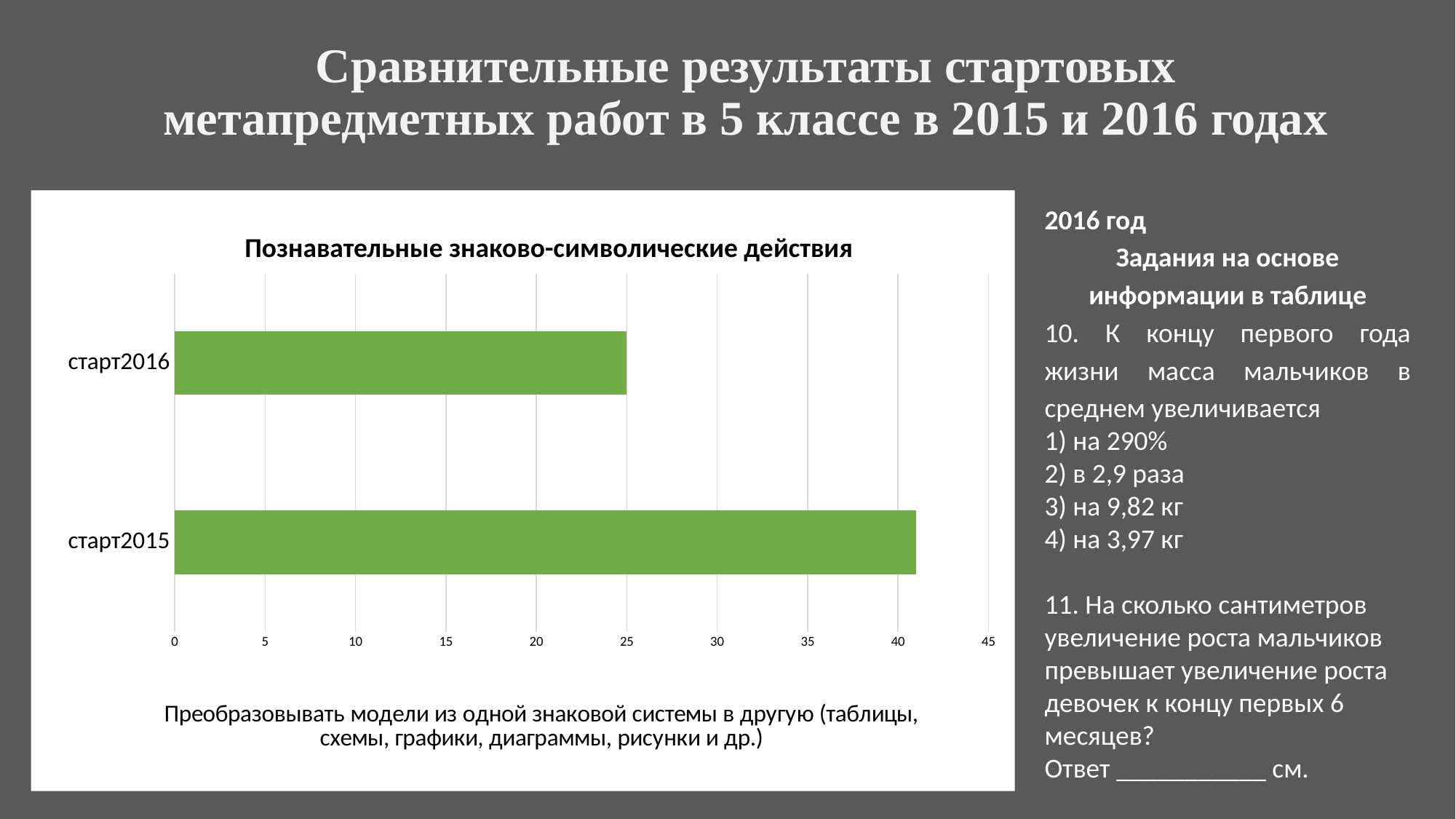
What is the highest value shown on the horizontal axis of the chart? 45 How many categories (bars) does the chart show? 2 Which category has the lowest value in the chart? старт2016 Which is larger, the value for старт2015 or the value for старт2016? старт2015 What colour are the bars in the chart? green Is the value for старт2015 greater or less than 40? greater What kind of chart is shown on the slide? bar chart Did the value fall or rise from старт2015 to старт2016? fall Is the value for старт2016 greater or less than 30? less What value does the bar for старт2016 reach on the axis? 25 What is the title of the chart? Познавательные знаково-символические действия Which category has the highest value in the chart? старт2015